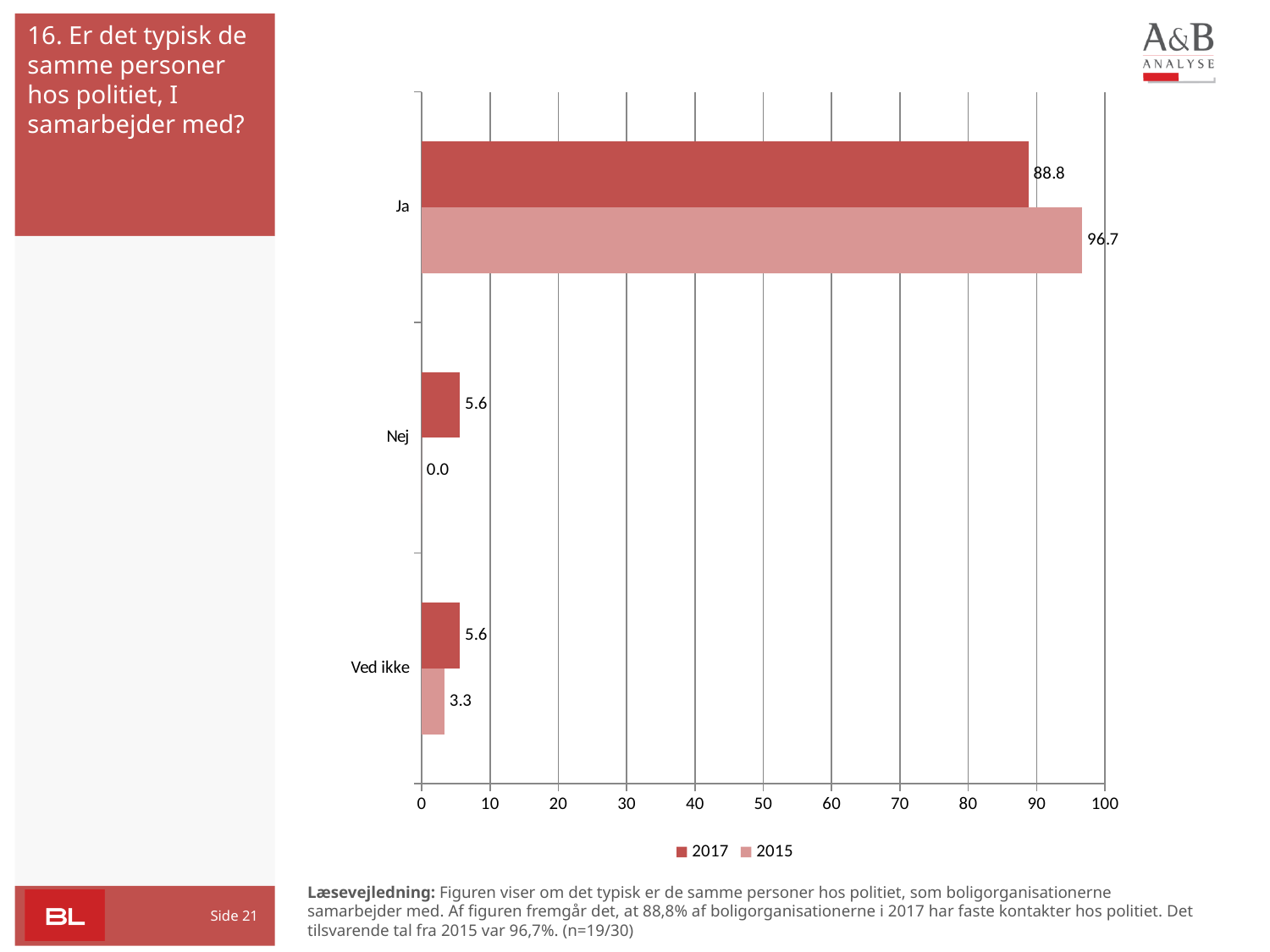
What is the value for Ved ikke in the 2017 series? 5.6 What is the difference between the 2015 and 2017 values for Ja? 7.9 How many categories are shown on the chart? 3 Which is larger for Ved ikke, the 2017 value or the 2015 value? 2017 What kind of chart is shown on the slide? Bar chart Is the 2017 value for Ja greater or less than 80? greater What is the value for Nej in the 2015 series? 0.0 Which category has the highest value in the 2015 series? Ja What is the value for Ja in the 2017 series? 88.8 What is the value for Ja in the 2015 series? 96.7 How many series does the legend list? 2 Which category has the lowest value in the 2015 series? Nej